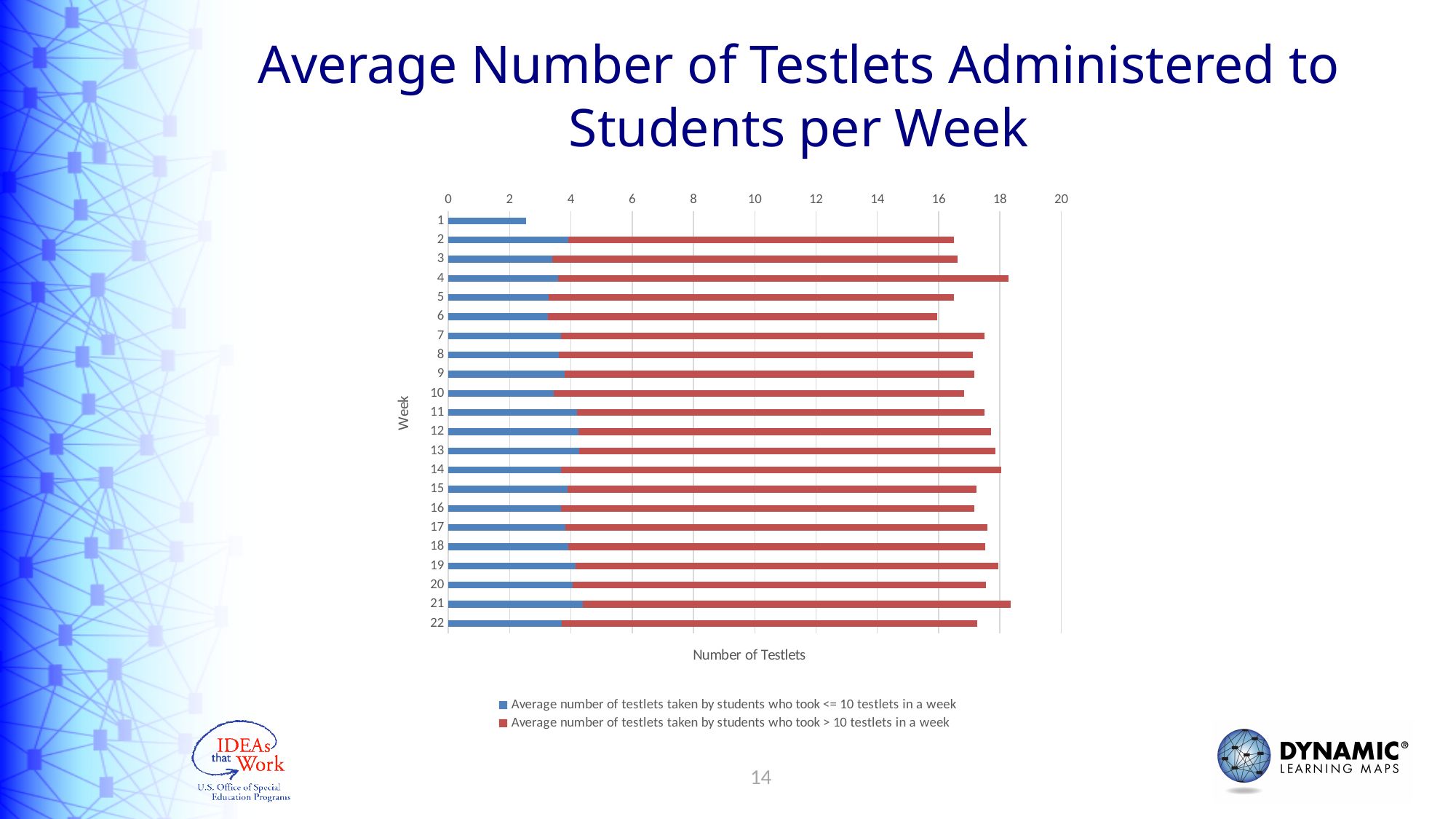
Is the value for week 1 greater or less than 4? less What kind of chart is shown on the slide? Bar chart Is the total value for week 6 greater or less than 14? greater Which has a larger total, week 6 or week 21? Week 21 How many series does the legend list? 2 What is the title of the chart? Average Number of Testlets Administered to Students per Week Is the total value for week 21 greater or less than 18? greater Which has a larger total, week 1 or week 2? Week 2 How many weeks are plotted on the chart? 22 What is the label of the horizontal axis? Number of Testlets Which week has the lowest total number of testlets? Week 1